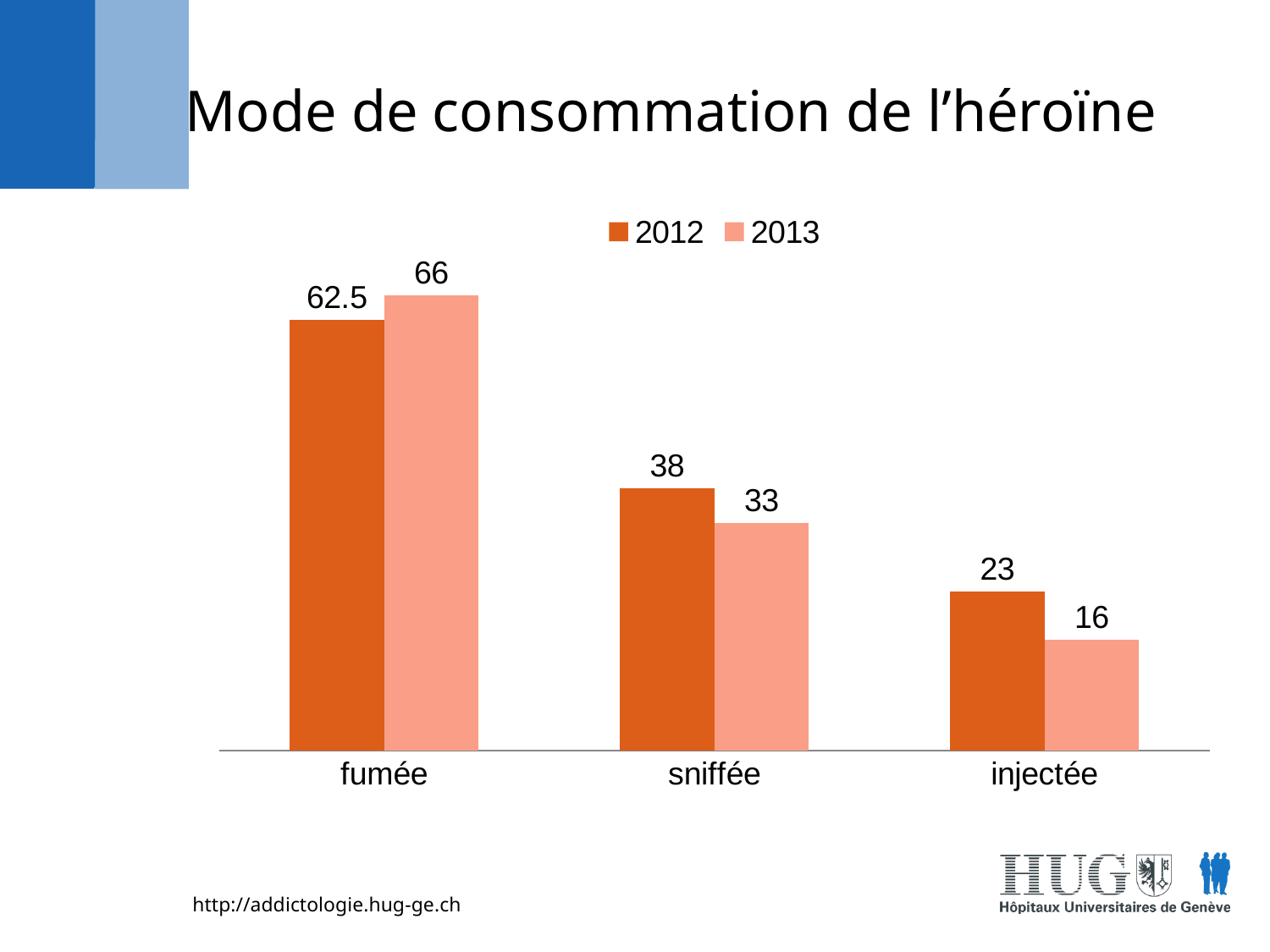
Which category has the highest value in 2013? fumée How many categories are shown on the x axis? 3 Which is larger for injectée, the 2012 value or the 2013 value? 2012 What kind of chart is shown on the slide? bar chart Which category has the lowest value in 2012? injectée What is the value for sniffée in 2013? 33 How many series does the legend list? 2 What is the value for fumée in 2012? 62.5 What is the title of the slide? Mode de consommation de l'héroïne What is the value for injectée in 2013? 16 What is the difference between the 2013 values for fumée and injectée? 50 What is the difference between the 2012 and 2013 values for sniffée? 5